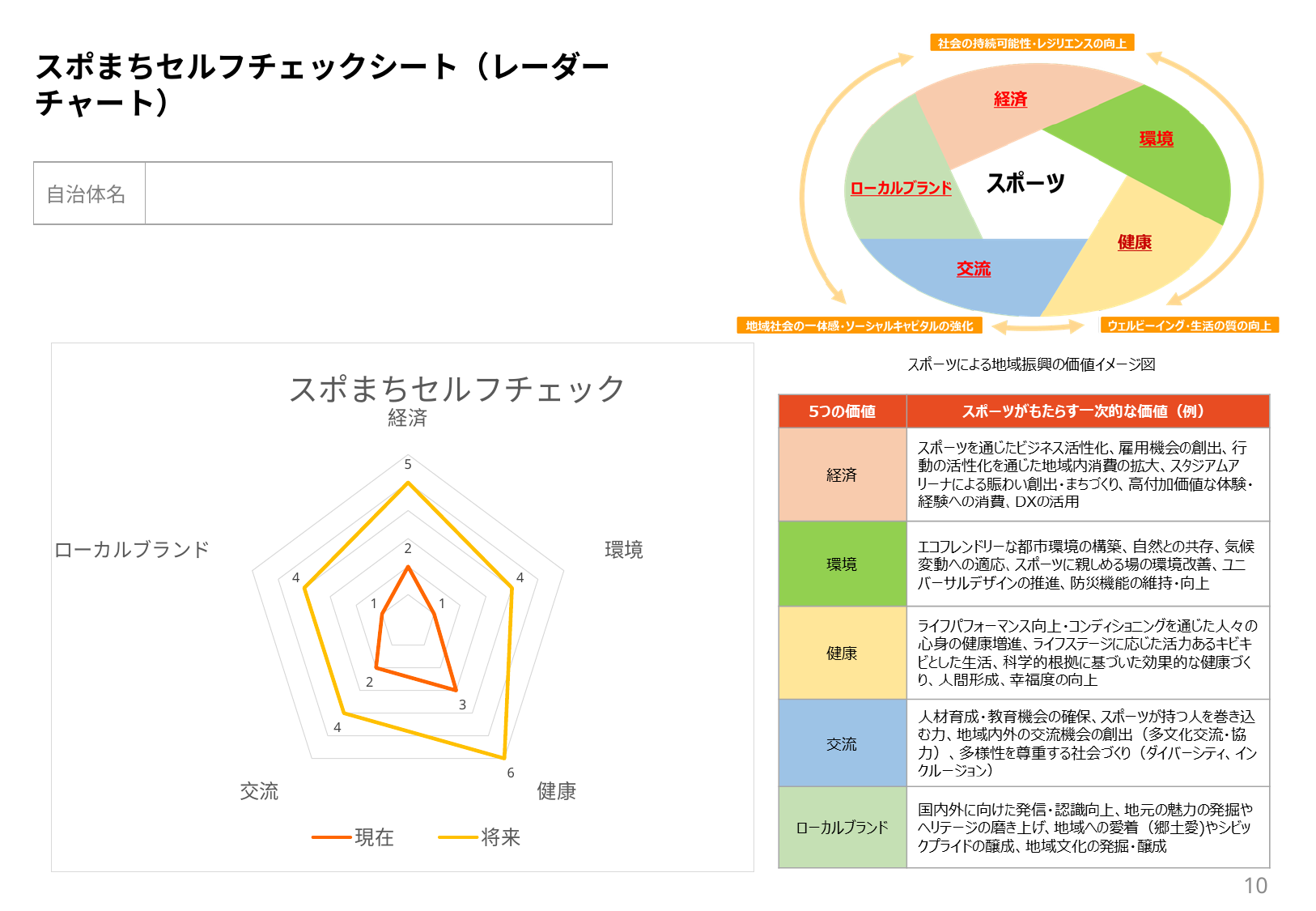
In the "スポまちセルフチェック" chart, what is the difference between the 将来 and 現在 values for 経済? 3 In the "スポまちセルフチェック" chart, what is the 将来 value for 健康? 6 In the "スポまちセルフチェック" chart, what is the difference between the 将来 and 現在 values for 健康? 3 In the "スポまちセルフチェック" chart, is the 現在 value for 交流 larger or smaller than the 将来 value for 交流? smaller In the "スポまちセルフチェック" chart, which category has the highest 現在 value? 健康 How many series does the legend of the "スポまちセルフチェック" chart list? 2 In the "スポまちセルフチェック" chart, what is the 現在 value for 経済? 2 In the "スポまちセルフチェック" chart, which category has the highest 将来 value? 健康 What kind of chart is the "スポまちセルフチェック" chart? radar chart In the "スポまちセルフチェック" chart, what is the 現在 value for 健康? 3 How many categories (axes) does the "スポまちセルフチェック" radar chart have? 5 In the "スポまちセルフチェック" chart, what is the 将来 value for ローカルブランド? 4